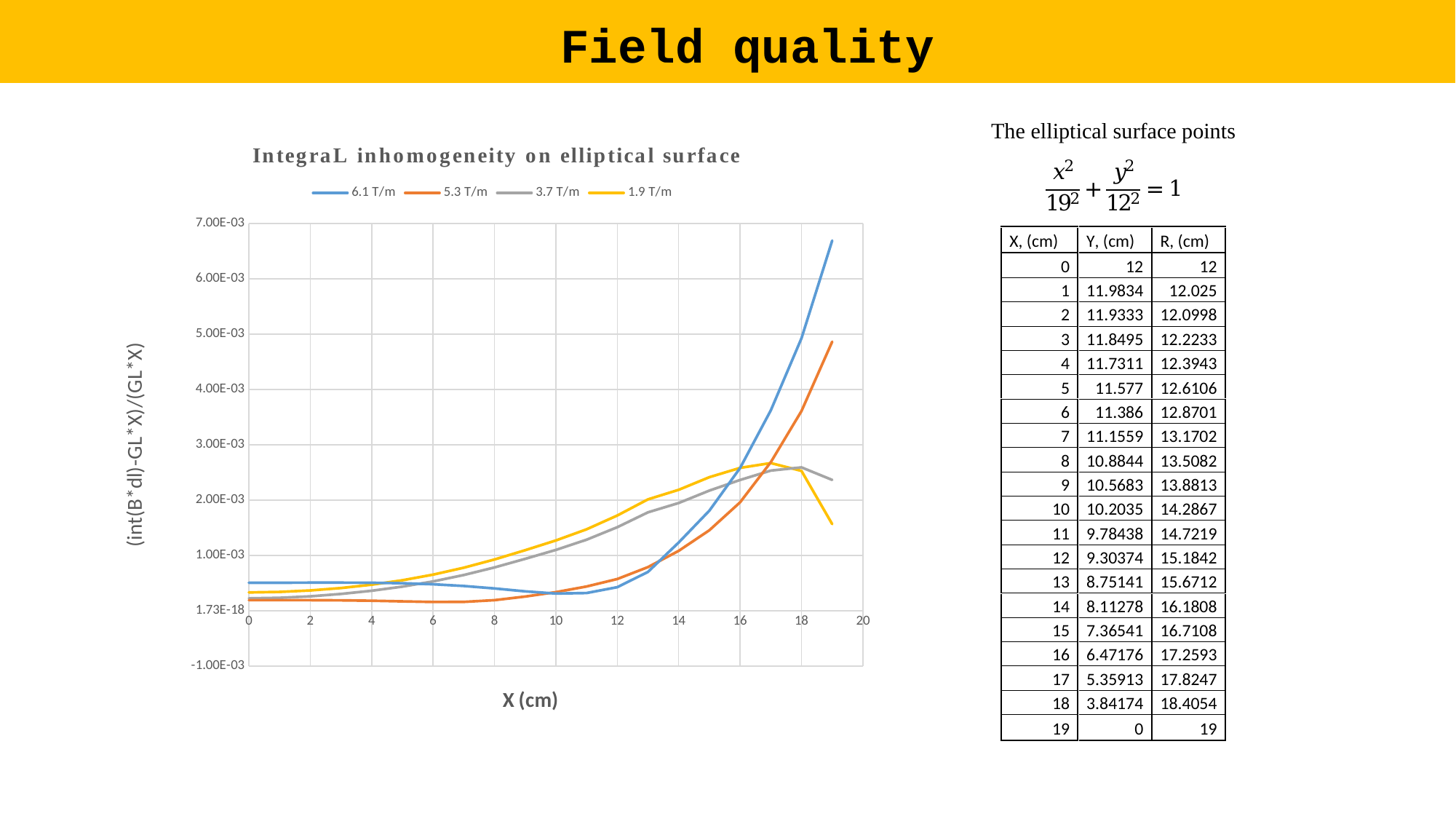
Which series has the highest value at X = 19 cm? 6.1 T/m Is the value of the 1.9 T/m series at X = 19 cm greater or less than 2.00E-03? less What is the title of the chart? IntegraL inhomogeneity on elliptical surface How many series does the legend of the chart list? 4 Is the value of the 3.7 T/m series at X = 19 cm greater or less than 2.00E-03? greater What is the x-axis title of the chart? X (cm) What kind of chart is shown on the slide? line chart At X = 10 cm, which series has the larger value, 1.9 T/m or 6.1 T/m? 1.9 T/m Does the 6.1 T/m series rise or fall between X = 12 cm and X = 19 cm? rise Which series has the lowest value at X = 19 cm? 1.9 T/m Is the value of the 5.3 T/m series at X = 19 cm greater or less than 4.00E-03? greater